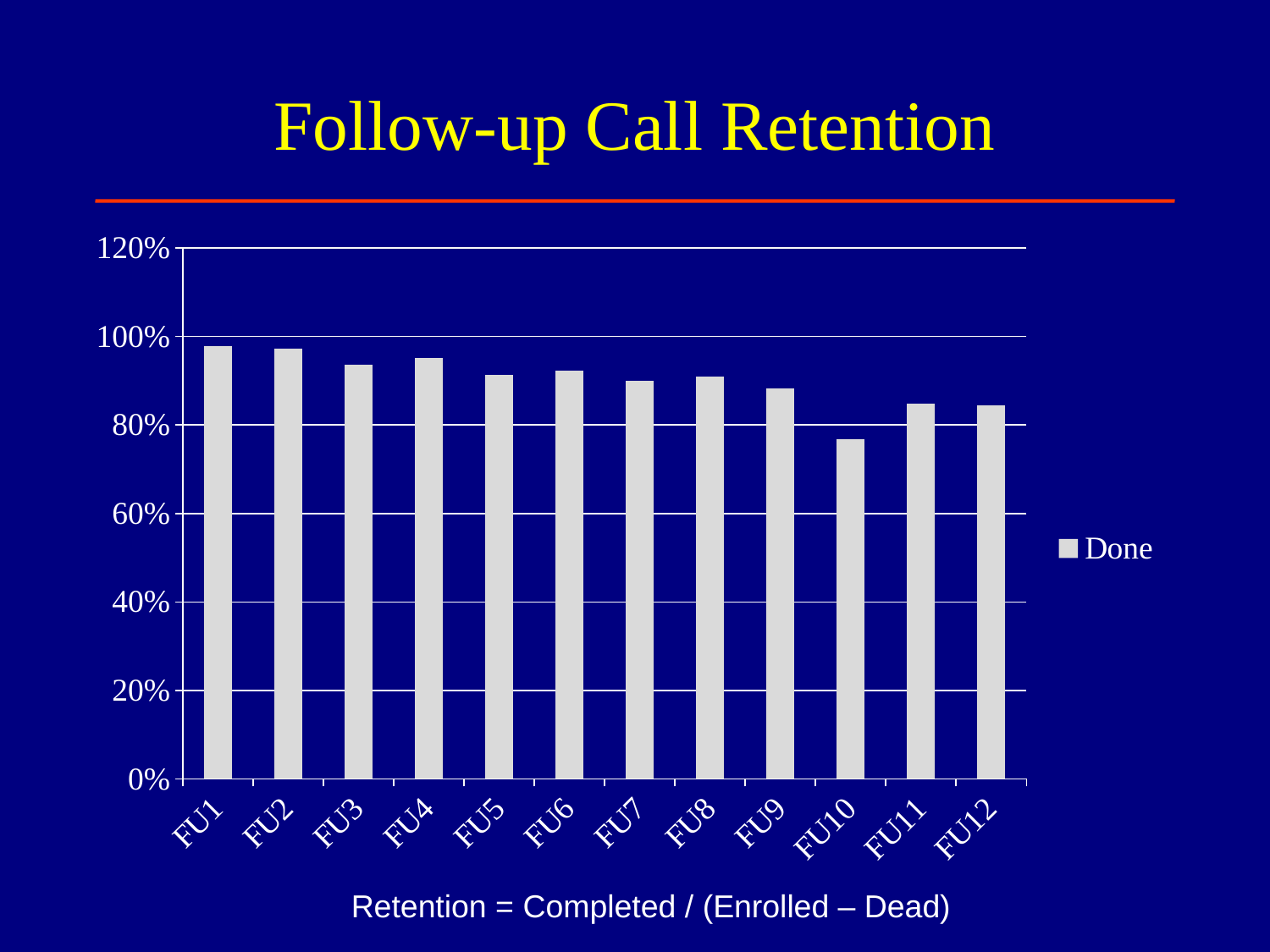
What kind of chart is shown on the slide? bar chart Is the value for FU10 greater or less than 80%? less Which is larger, the value for FU1 or the value for FU10? FU1 What is the name of the series shown in the legend? Done How many series does the legend list? 1 Is the value for FU9 greater or less than 80%? greater What is the title of the chart? Follow-up Call Retention Is the value for FU3 greater or less than 100%? less How many follow-up call categories are plotted on the x axis? 12 Do the retention values generally rise or fall from FU1 to FU12? fall Which follow-up call has the lowest retention? FU10